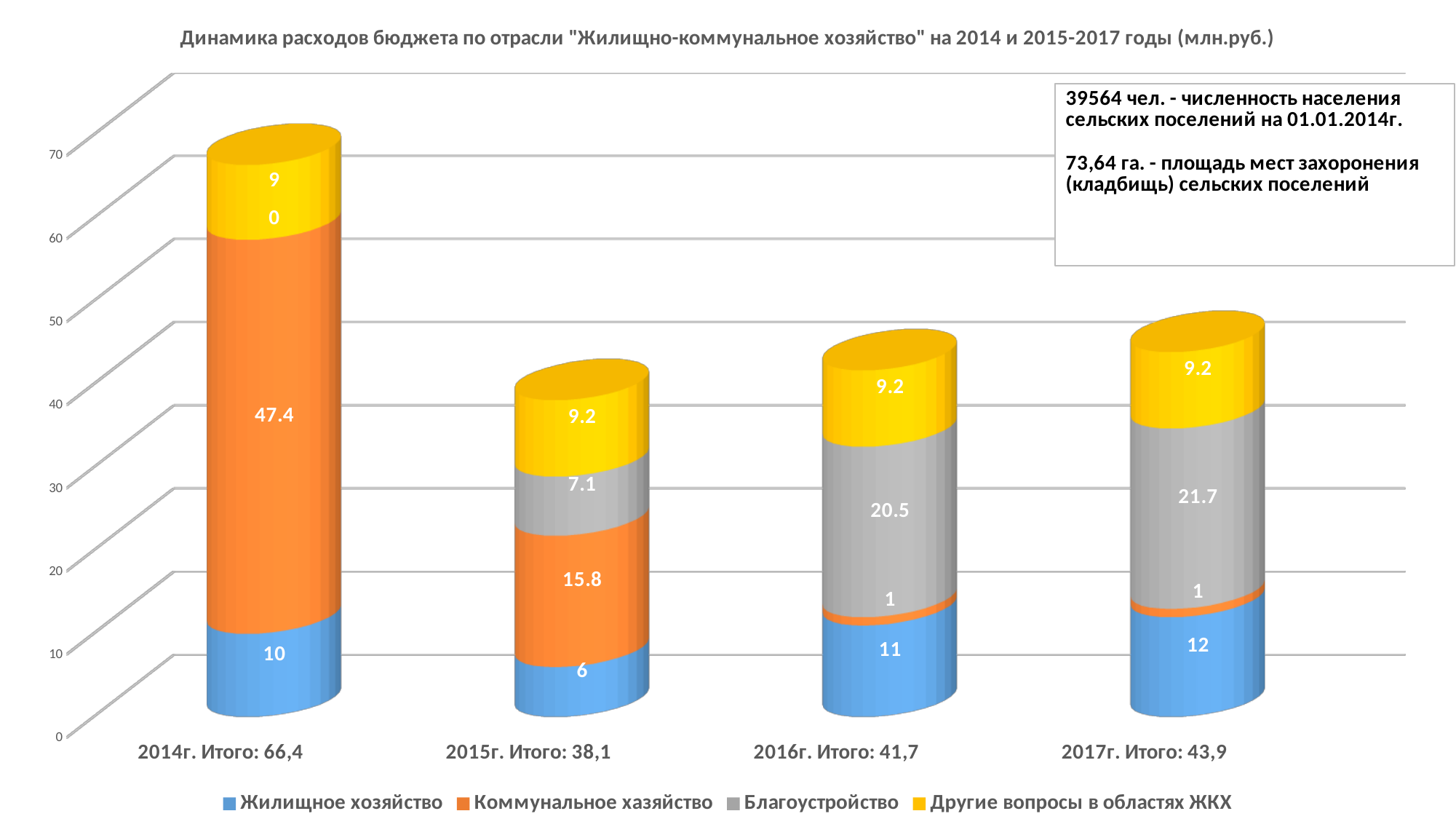
How many year categories are shown on the x axis? 4 What is the total of the stacked bar for 2016? 41,7 Which year has the lowest total expenditure? 2015г. Итого: 38,1 Which is larger: Жилищное хозяйство in 2017 or in 2016? 2017 What is the difference between the Благоустройство values for 2017 and 2016? 1.2 What type of chart is shown on the slide? stacked bar chart What is the value for Коммунальное хазяйство in 2014? 47.4 What is the value for Благоустройство in 2017? 21.7 How many series does the legend list? 4 Which year has the highest total expenditure? 2014г. Итого: 66,4 What is the value for Жилищное хозяйство in 2015? 6 What is the value for Другие вопросы в областях ЖКХ in 2016? 9.2